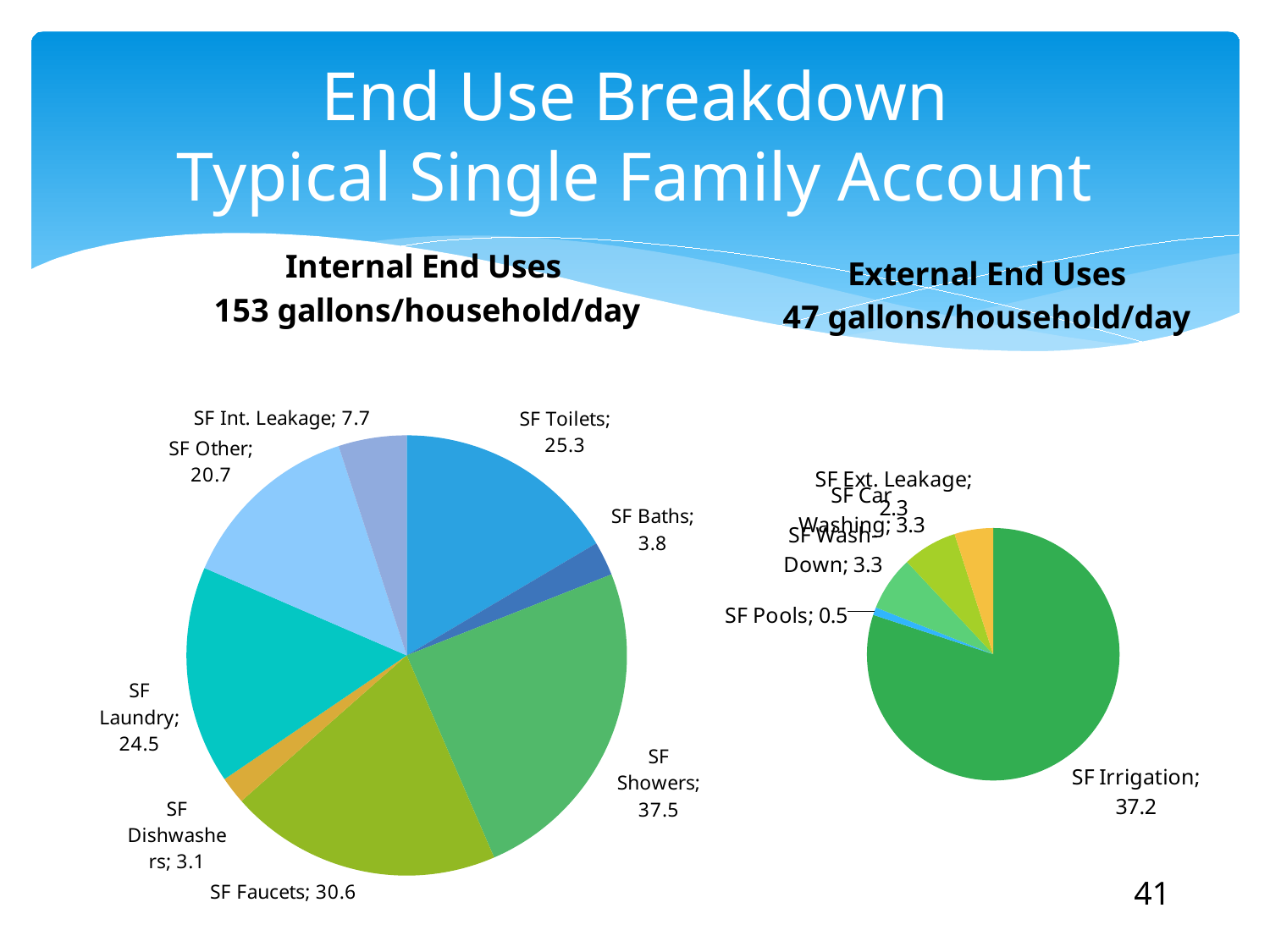
In the External End Uses pie chart, what is the value for SF Irrigation? 37.2 In the Internal End Uses pie chart, what is the difference between SF Showers and SF Toilets? 12.2 How many slices does the Internal End Uses pie chart have? 8 What type of chart is used for the External End Uses? Pie chart In the Internal End Uses pie chart, which category has the smallest value? SF Dishwashers In the Internal End Uses pie chart, which is larger, SF Laundry or SF Other? SF Laundry In the External End Uses pie chart, which category has the smallest value? SF Pools In the Internal End Uses pie chart, what is the value for SF Faucets? 30.6 In the Internal End Uses pie chart, which category has the largest value? SF Showers In the Internal End Uses pie chart, what is the value for SF Showers? 37.5 In the Internal End Uses pie chart, what is the value for SF Dishwashers? 3.1 In the External End Uses pie chart, what is the value for SF Pools? 0.5